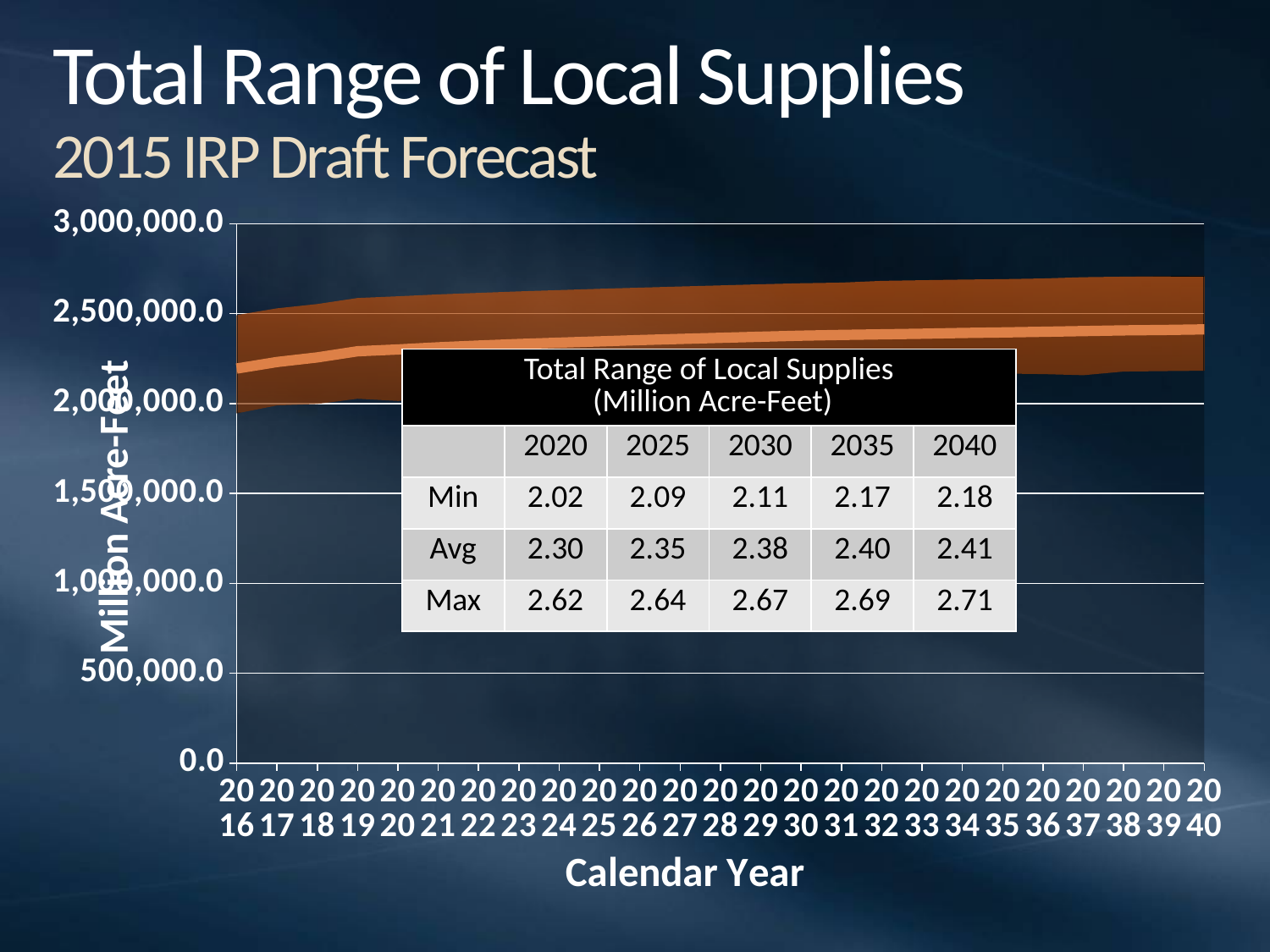
In the table, which year has the lowest Min value? 2020 What is the title of the x axis of the chart? Calendar Year In the table, which is larger: the Avg value for 2025 or the Avg value for 2035? 2035 In the table, which year has the highest Max value? 2040 According to the table on the slide, what is the Avg value of Total Range of Local Supplies in 2030? 2.38 Does the range of local supplies rise or fall from 2016 to 2040 along the x axis? rise In the table, what is the difference between the Max and Min values for 2040? 0.53 Is the lower edge of the shaded range in 2040 greater or less than 2,000,000.0? greater According to the table on the slide, what is the Min value of Total Range of Local Supplies in 2020? 2.02 What kind of chart is shown on the slide? area and line chart According to the table on the slide, what is the Max value of Total Range of Local Supplies in 2040? 2.71 How many calendar years are shown on the x axis of the chart? 25